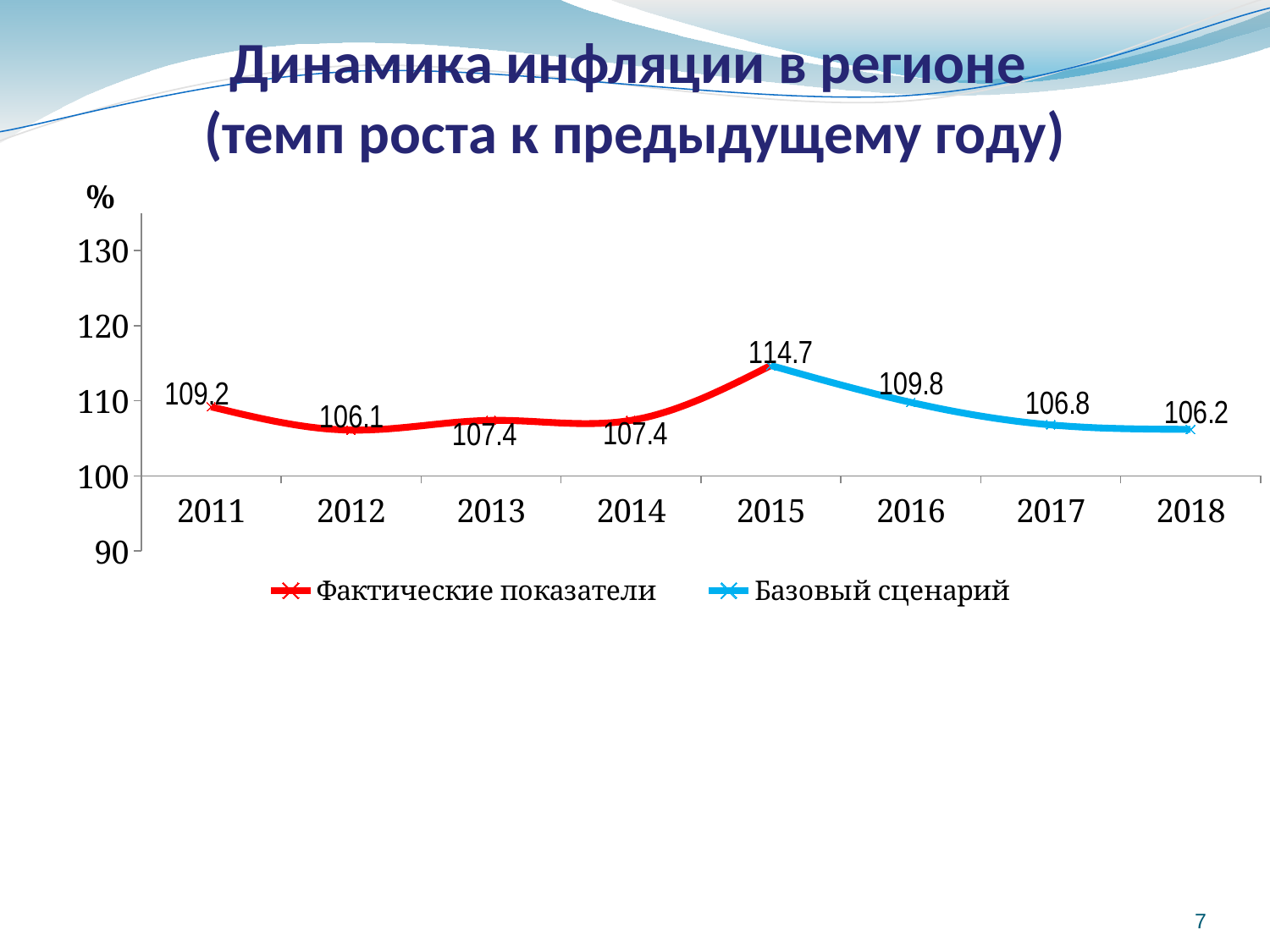
How many series does the legend list? 2 Do the values of the Базовый сценарий series rise or fall from 2015 to 2018? fall How many years are shown on the x axis of the chart? 8 What is the value for 2011 in the chart? 109.2 Which year has the highest value in the chart? 2015 What is the value of the Базовый сценарий series for 2018? 106.2 What is the value for 2015 in the chart? 114.7 What is the value for 2016 in the chart? 109.8 What type of chart is shown on the slide? line chart Which is larger, the value for 2011 or the value for 2017? 2011 What is the difference between the values for 2015 and 2016? 4.9 Which year has the lowest value in the chart? 2012